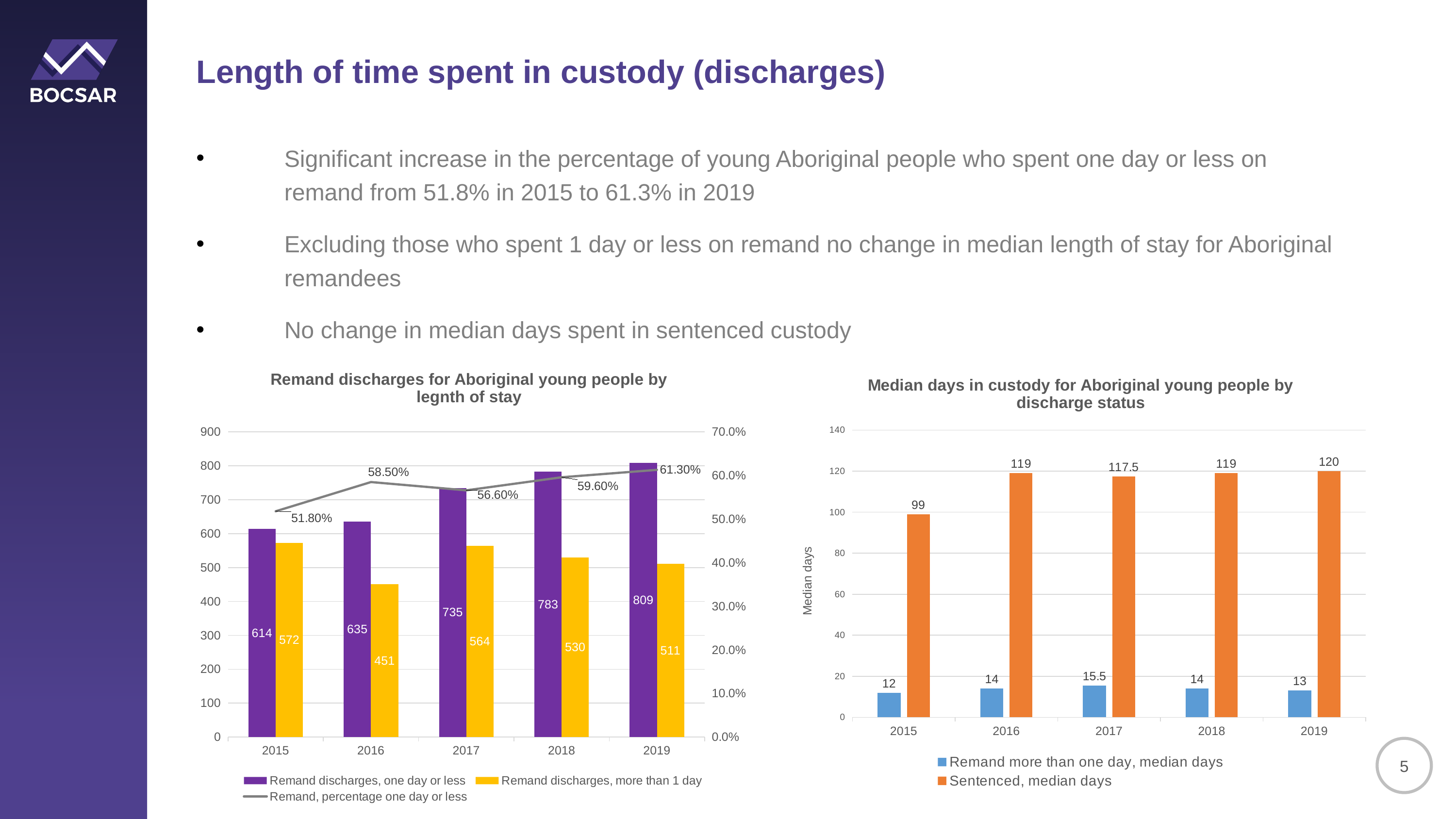
In the 'Remand discharges for Aboriginal young people by legnth of stay' chart, how many series does the legend list? 3 In the 'Median days in custody for Aboriginal young people by discharge status' chart, which year has the lowest 'Sentenced, median days' value? 2015 In the 'Remand discharges for Aboriginal young people by legnth of stay' chart, which year has the highest value for 'Remand discharges, one day or less'? 2019 In the 'Remand discharges for Aboriginal young people by legnth of stay' chart, what is the difference between 'Remand discharges, one day or less' and 'Remand discharges, more than 1 day' in 2019? 298 In the 'Remand discharges for Aboriginal young people by legnth of stay' chart, what is the value for 'Remand discharges, more than 1 day' in 2016? 451 In the 'Remand discharges for Aboriginal young people by legnth of stay' chart, which year has the lowest value for 'Remand discharges, more than 1 day'? 2016 In the 'Remand discharges for Aboriginal young people by legnth of stay' chart, what is the 'Remand, percentage one day or less' value for 2019? 61.30% In the 'Remand discharges for Aboriginal young people by legnth of stay' chart, what is the value for 'Remand discharges, one day or less' in 2017? 735 In the 'Median days in custody for Aboriginal young people by discharge status' chart, which year has the highest 'Remand more than one day, median days' value? 2017 In the 'Median days in custody for Aboriginal young people by discharge status' chart, how many years are shown on the x axis? 5 In the 'Median days in custody for Aboriginal young people by discharge status' chart, what is the 'Sentenced, median days' value for 2017? 117.5 In the 'Median days in custody for Aboriginal young people by discharge status' chart, what is the difference between 'Sentenced, median days' and 'Remand more than one day, median days' in 2015? 87